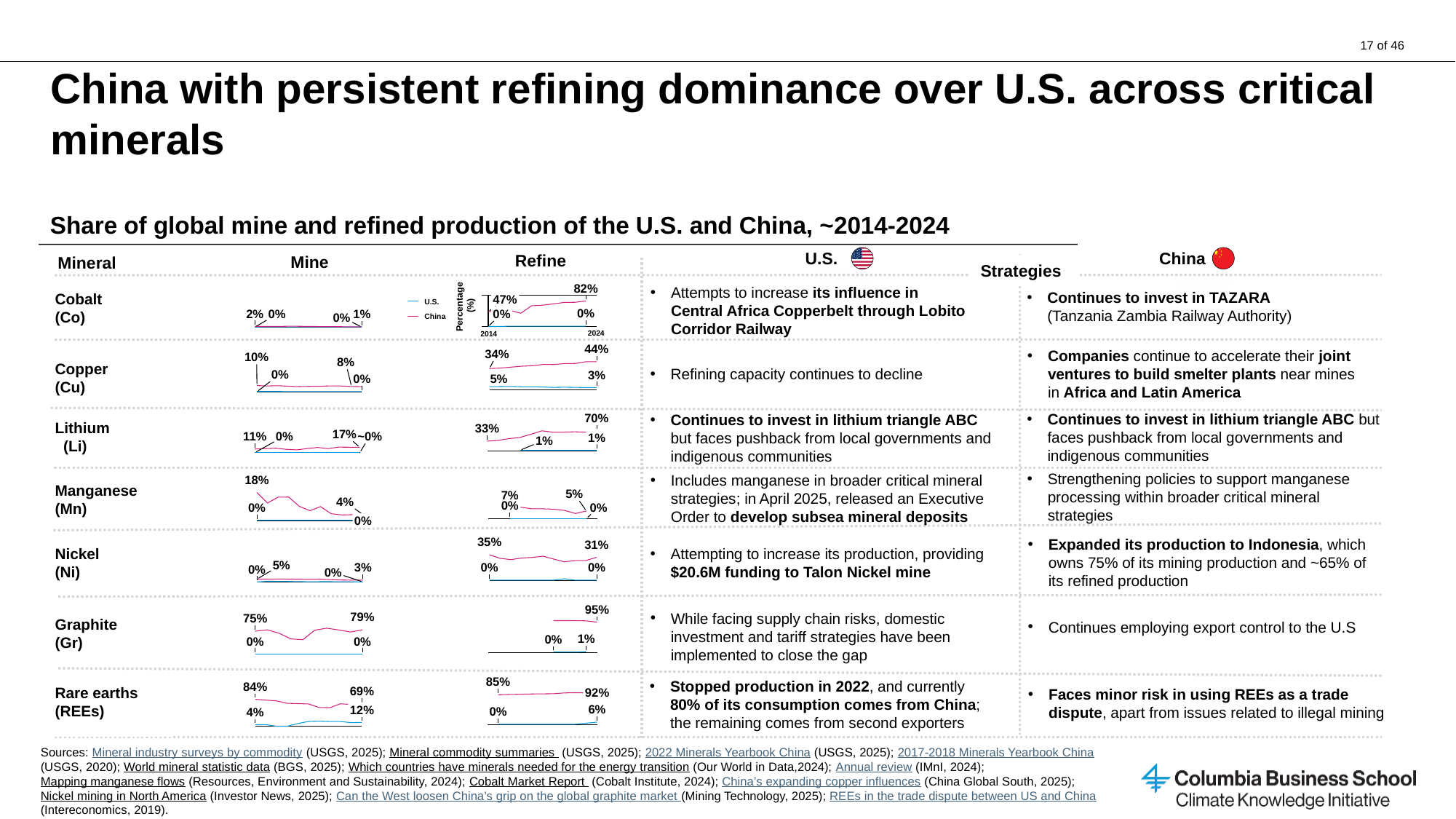
How many series does the legend list for the charts? 2 In the Cobalt Refine chart, by how many percentage points did China's share rise from 2014 to 2024? 35 percentage points In the Rare earths Refine chart, which is larger at the end of the period, China's share or the U.S. share? China's share In the Rare earths Mine chart, what is China's share at the start of the period? 84% What kind of charts are used in the Mine and Refine columns? Line charts In the Lithium Refine chart, what is China's share at the end of the period? 70% In the Manganese Mine chart, does China's share rise or fall from the start to the end of the period? Fall How many minerals are shown as rows in the table of charts? 7 In the Rare earths Mine chart, what is the U.S. share at the end of the period? 12% In the Cobalt Refine chart, what is China's share of global refined production in 2024? 82% In the Graphite Refine chart, what is the highest value labelled? 95% In the Cobalt Refine chart, what is China's share of global refined production in 2014? 47%